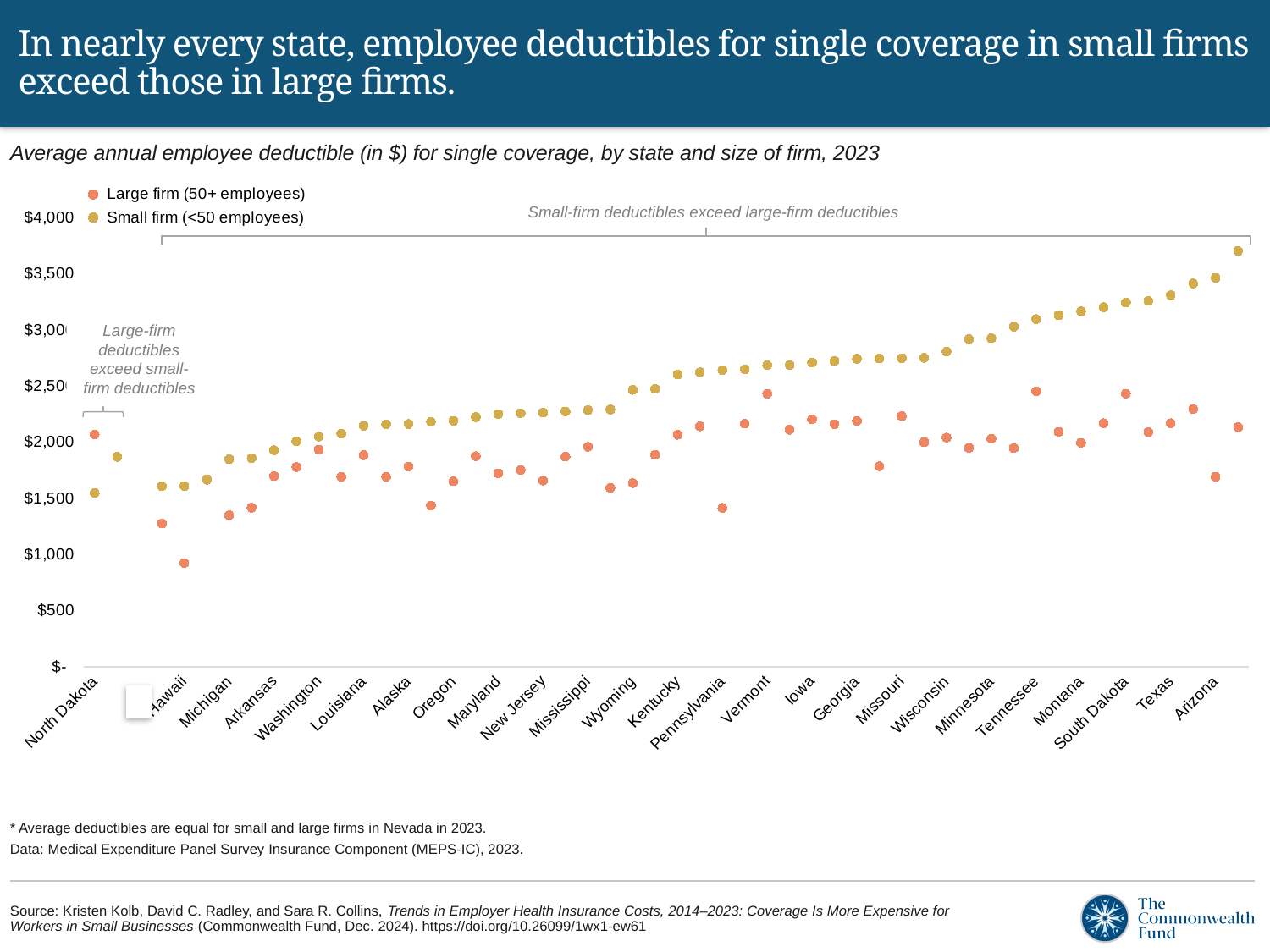
What kind of chart is shown on the slide? Scatter (dot) chart How many series does the legend list? 2 Do the small-firm deductibles generally rise or fall moving from left to right along the x axis? Rise Which labeled state has the lowest large-firm deductible? Hawaii Which labeled state has the highest small-firm deductible? Arizona Is the large-firm deductible for Hawaii greater or less than $1,500? less For Arizona, which is larger: the large-firm deductible or the small-firm deductible? Small firm Is the large-firm deductible for Wyoming greater or less than $2,000? less For North Dakota, which is larger: the large-firm deductible or the small-firm deductible? Large firm Is the small-firm deductible for Texas greater or less than $3,000? greater Which series is shown with orange-red dots? Large firm (50+ employees)